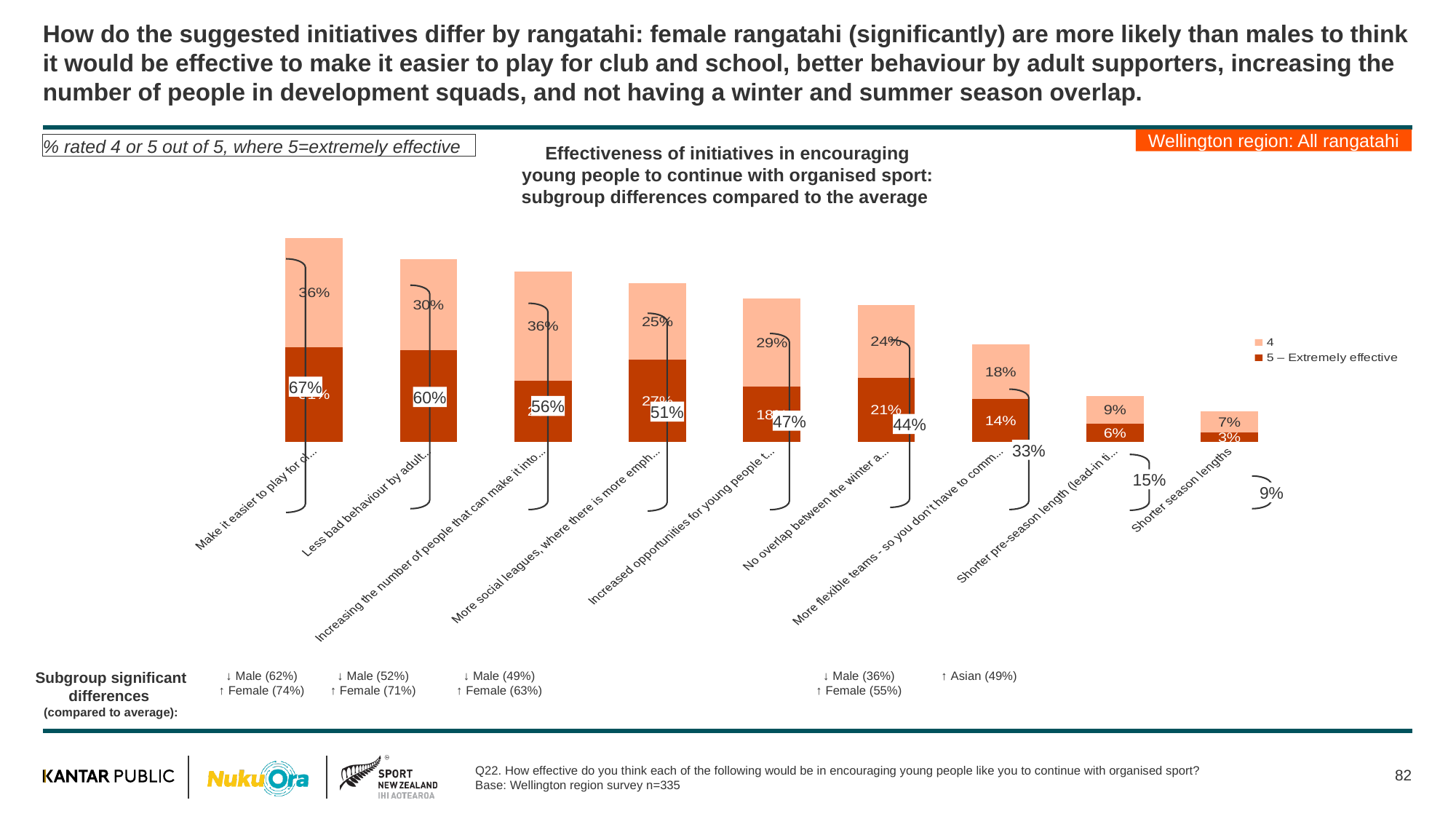
Which initiative has the highest total percentage rated 4 or 5? Make it easier to play for cl... (67%) Which initiative has the lowest total percentage rated 4 or 5? Shorter season lengths (9%) How many initiatives (bars) are plotted in the chart? 9 What is the '4' segment value for the 'Less bad behaviour by adult...' initiative? 30% What is the total percentage (rated 4 or 5) shown for 'Shorter season lengths'? 9% How many series does the chart legend list? 2 What is the '4' segment value for 'Shorter season lengths'? 7% Do the total percentages rise or fall moving from left to right across the bars? Fall What is the difference between the total for the first bar (67%) and the total for 'Shorter season lengths' (9%)? 58% What kind of chart is shown on the slide? Stacked bar chart What is the '5 – Extremely effective' value for the 'More flexible teams' initiative? 14% For the 'No overlap between the winter a...' initiative, which segment is larger: '4' or '5 – Extremely effective'? 4 (24%)